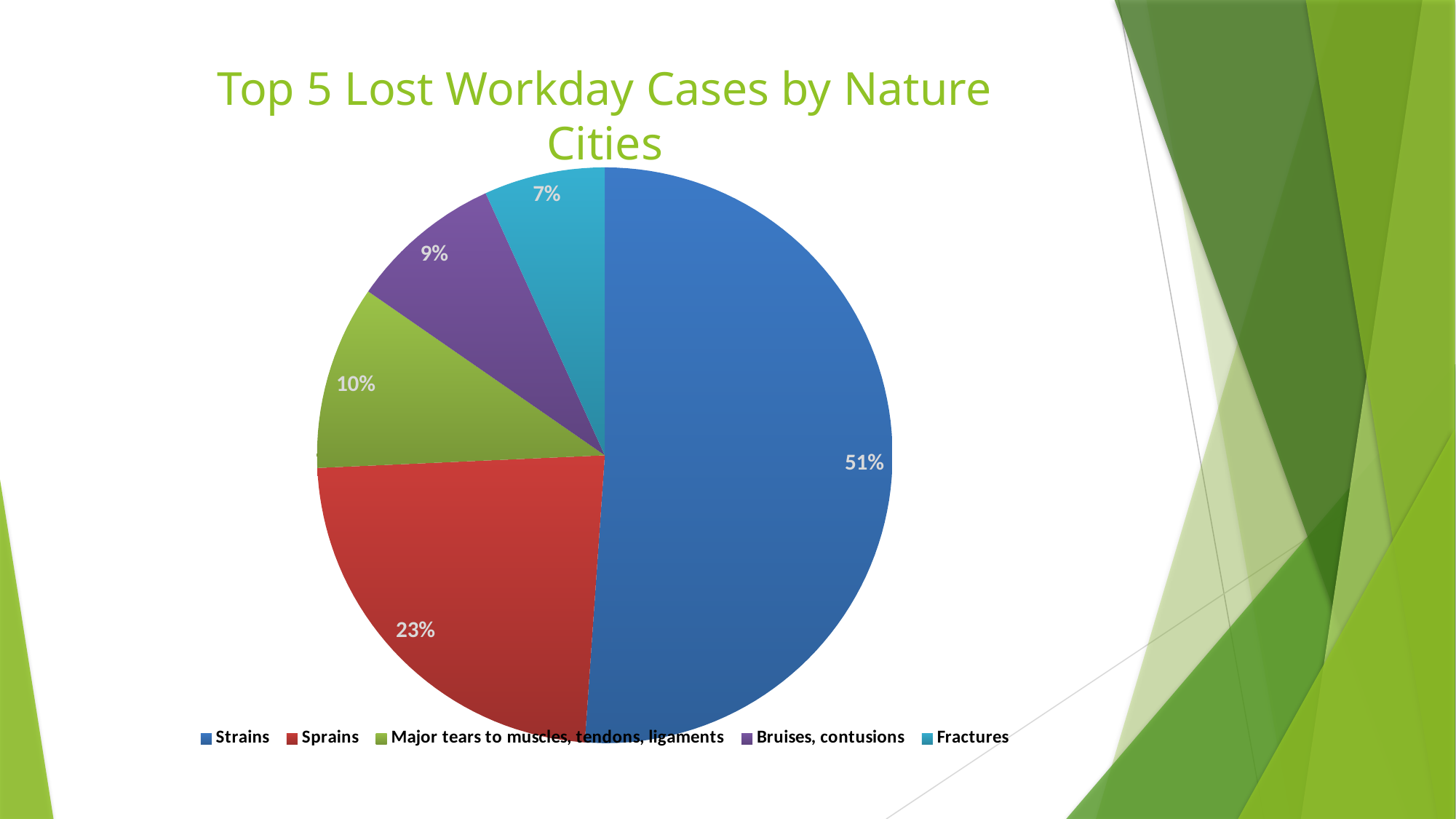
What percentage is shown for Major tears to muscles, tendons, ligaments? 10% Which category has the largest slice of the pie? Strains Which is larger, the share for Bruises, contusions or the share for Fractures? Bruises, contusions What is the difference in percentage points between Strains and Sprains? 28 What is the title of the chart? Top 5 Lost Workday Cases by Nature Cities What percentage is shown for Bruises, contusions? 9% What share of the pie does Strains account for? 51% What kind of chart is shown on the slide? Pie chart Which category has the smallest slice of the pie? Fractures How many categories does the pie chart show? 5 What percentage is shown for Fractures? 7% What share of the pie does Sprains account for? 23%